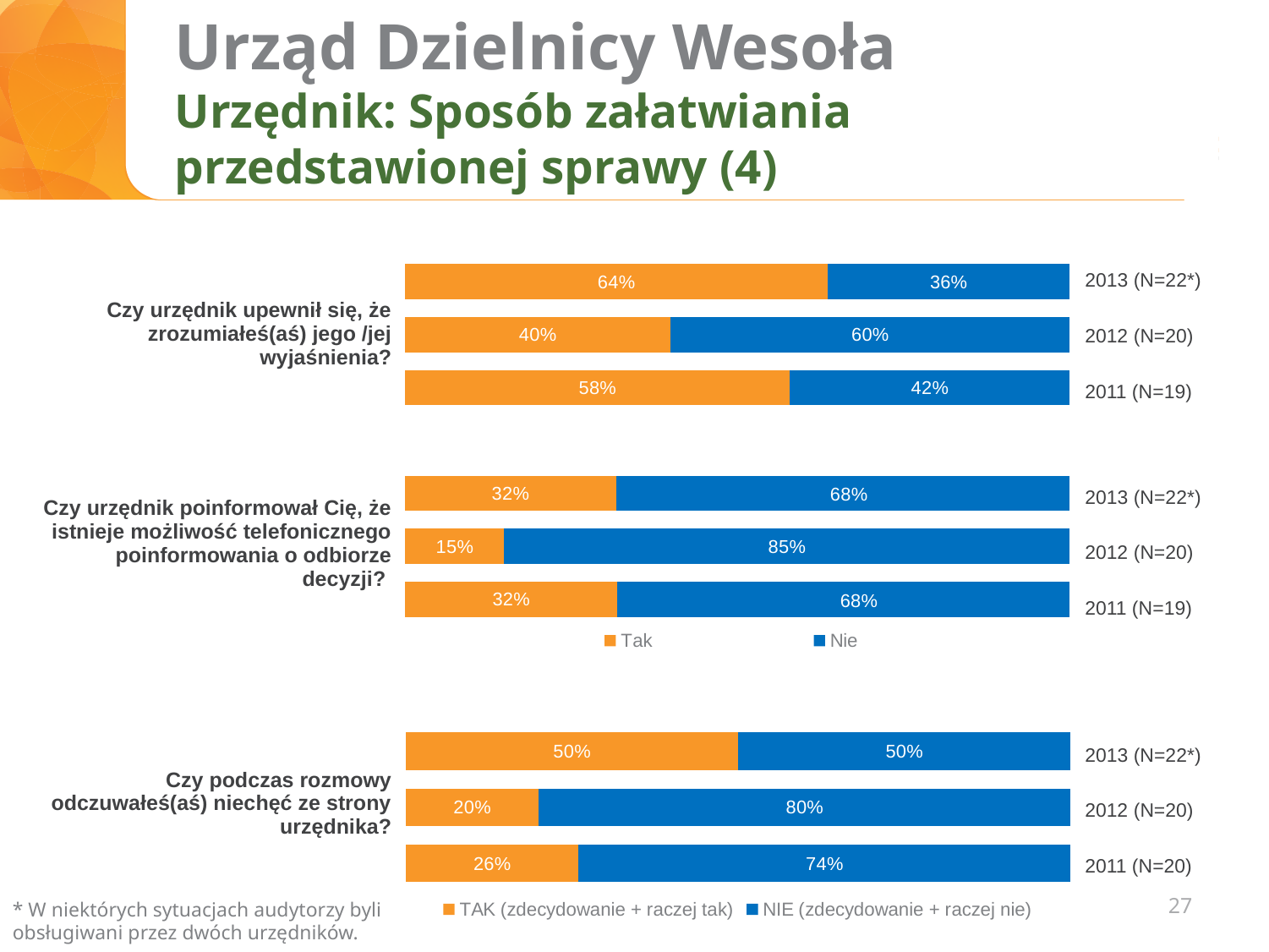
In the bottom chart ("Czy podczas rozmowy odczuwałeś(aś) niechęć ze strony urzędnika?"), what is the TAK value for 2011 (N=20)? 26% In the top chart ("Czy urzędnik upewnił się, że zrozumiałeś(aś) jego /jej wyjaśnienia?"), what is the Tak value for 2013 (N=22*)? 64% In the bottom chart ("Czy podczas rozmowy odczuwałeś(aś) niechęć ze strony urzędnika?"), what is the difference between the NIE values for 2012 and 2013? 30% In the middle chart ("Czy urzędnik poinformował Cię, że istnieje możliwość telefonicznego poinformowania o odbiorze decyzji?"), which year has the highest Nie value? 2012 (N=20) In the top chart ("Czy urzędnik upewnił się, że zrozumiałeś(aś) jego /jej wyjaśnienia?"), which year has the lowest Tak value? 2012 (N=20) What type of chart is used in the top chart ("Czy urzędnik upewnił się, że zrozumiałeś(aś) jego /jej wyjaśnienia?")? Stacked bar chart In the top chart ("Czy urzędnik upewnił się, że zrozumiałeś(aś) jego /jej wyjaśnienia?"), what is the Nie value for 2012 (N=20)? 60% In the bottom chart ("Czy podczas rozmowy odczuwałeś(aś) niechęć ze strony urzędnika?"), how many series does the legend list? 2 In the middle chart ("Czy urzędnik poinformował Cię, że istnieje możliwość telefonicznego poinformowania o odbiorze decyzji?"), is the Tak value for 2013 larger or smaller than the Tak value for 2012? larger In the top chart ("Czy urzędnik upewnił się, że zrozumiałeś(aś) jego /jej wyjaśnienia?"), what is the difference between the Tak values for 2013 and 2011? 6% In the middle chart ("Czy urzędnik poinformował Cię, że istnieje możliwość telefonicznego poinformowania o odbiorze decyzji?"), how many years (bars) are shown? 3 In the middle chart ("Czy urzędnik poinformował Cię, że istnieje możliwość telefonicznego poinformowania o odbiorze decyzji?"), what is the Nie value for 2012 (N=20)? 85%